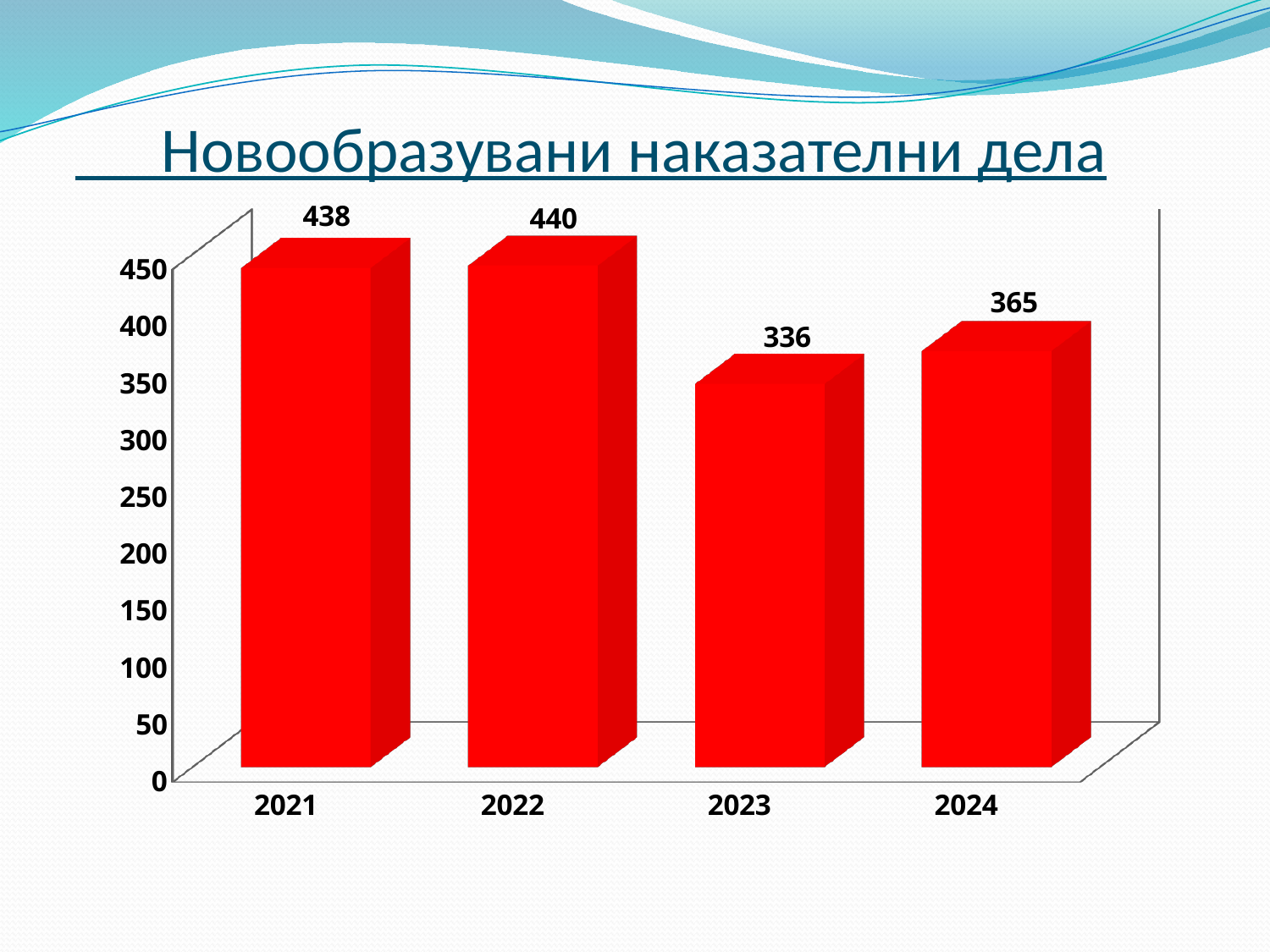
Is the value for 2023 greater or less than 350? less Which year has the lowest value? 2023 Which year has the highest value? 2022 How many years are shown on the x axis? 4 What kind of chart is shown on the slide? bar chart What is the value for 2024? 365 What is the value for 2023? 336 What is the value for 2021? 438 What is the difference between the values for 2024 and 2023? 29 What is the title of the chart? Новообразувани наказателни дела Which is larger, the value for 2021 or the value for 2024? 2021 What is the difference between the values for 2021 and 2023? 102